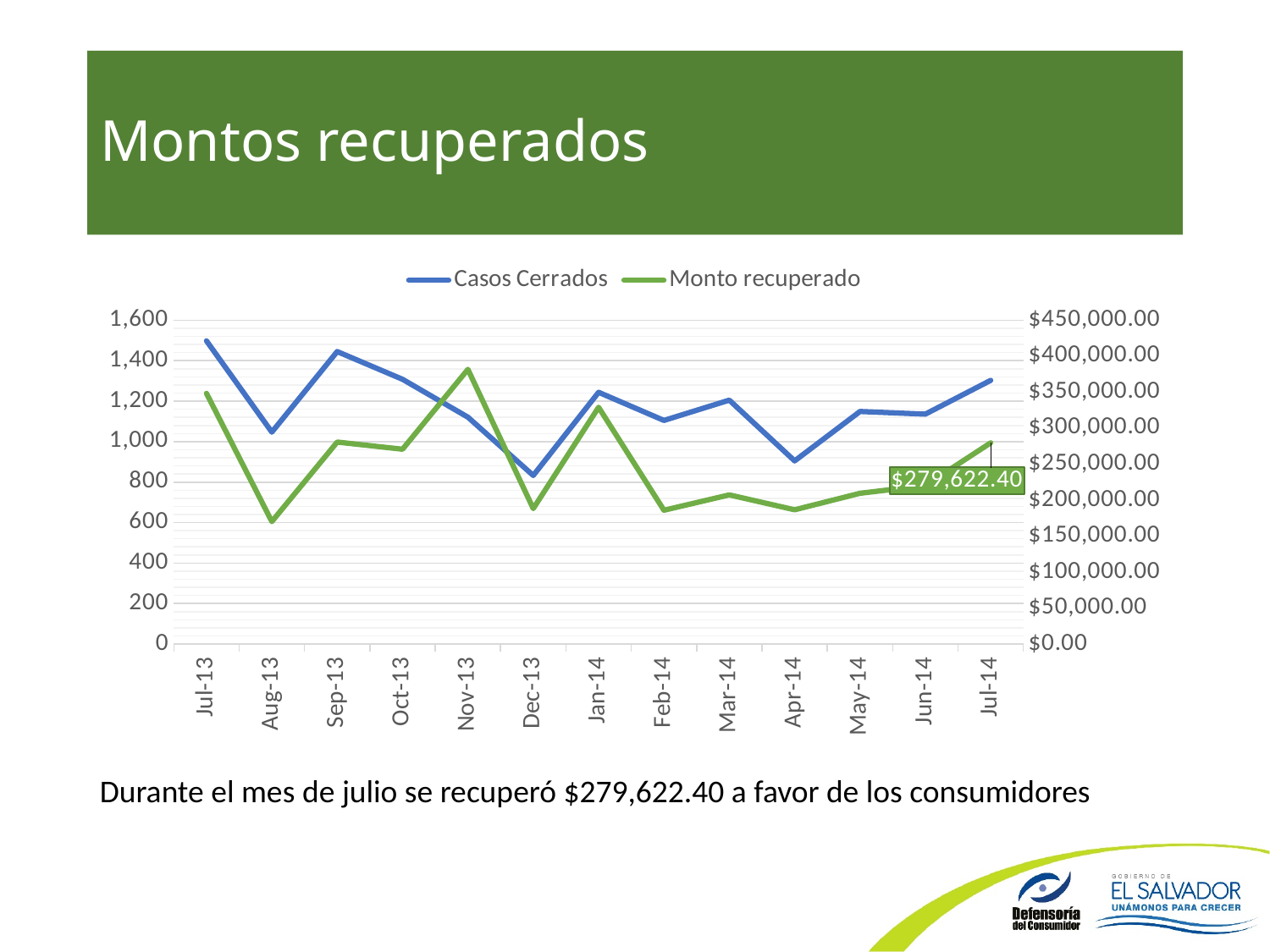
What colour is the Monto recuperado line? Green How many months are plotted along the x axis? 13 What is the Monto recuperado value labelled for Jul-14? $279,622.40 Is the Monto recuperado value for Nov-13 greater or less than $350,000.00? greater What kind of chart is shown on the slide? Line chart In which month is Casos Cerrados lowest? Dec-13 Is the Casos Cerrados value for Jul-13 greater or less than 1,400? greater Which month has more Casos Cerrados, Jan-14 or Apr-14? Jan-14 How many series does the legend list? 2 In which month is Monto recuperado lowest? Aug-13 Is the Casos Cerrados value for Dec-13 greater or less than 1,000? less In which month is Monto recuperado highest? Nov-13